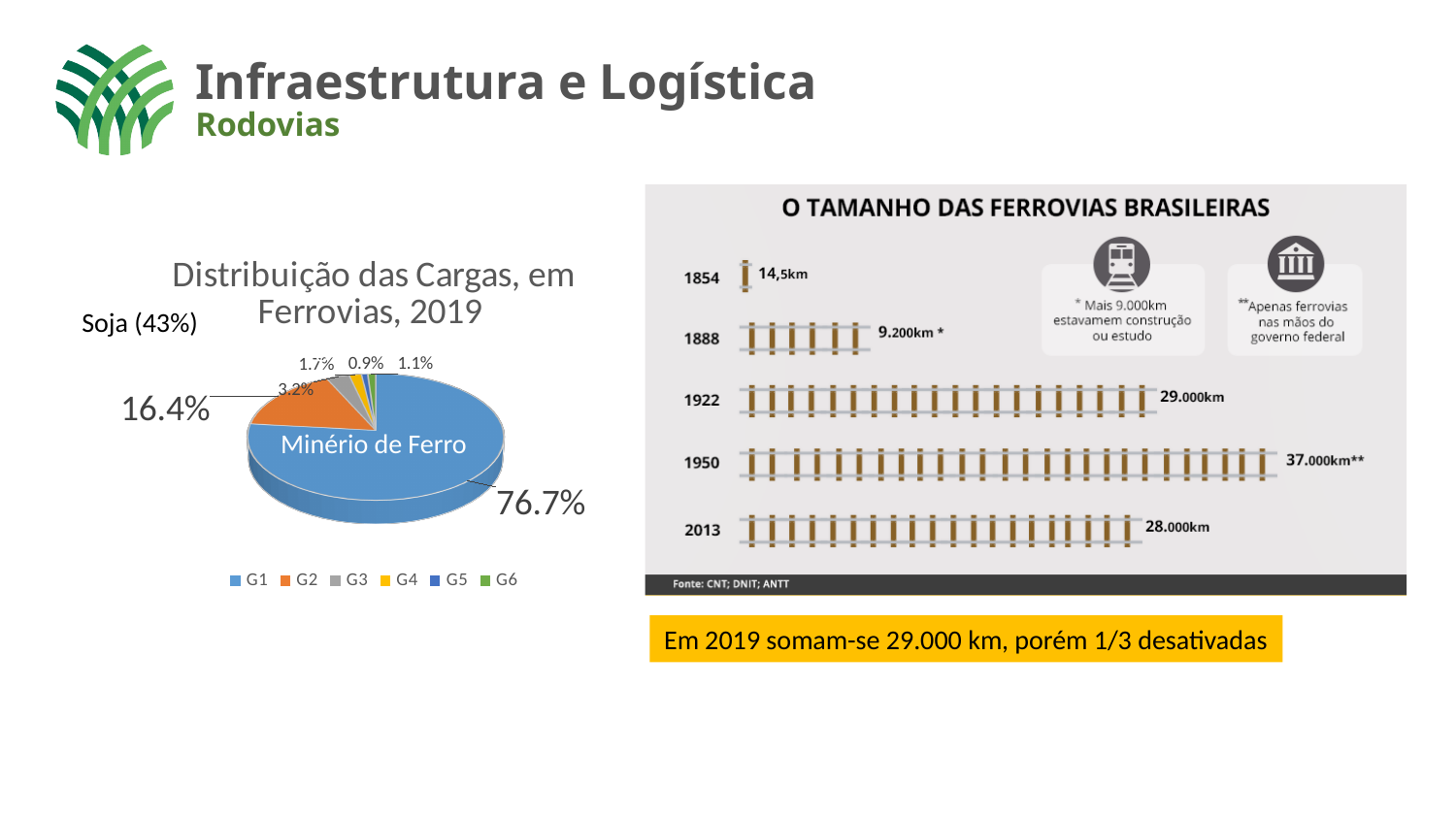
What kind of chart is 'Distribuição das Cargas, em Ferrovias, 2019'? pie chart In the pie chart 'Distribuição das Cargas, em Ferrovias, 2019', what is the value of the largest slice? 76.7% How many years are shown in the chart 'O Tamanho das Ferrovias Brasileiras'? 5 In the pie chart 'Distribuição das Cargas, em Ferrovias, 2019', what is the smallest percentage shown? 0.9% In the pie chart 'Distribuição das Cargas, em Ferrovias, 2019', what is the difference between the largest slice (76.7%) and the second largest (16.4%)? 60.3% In the pie chart 'Distribuição das Cargas, em Ferrovias, 2019', what label is written inside the largest slice? Minério de Ferro How many entries does the legend of the pie chart 'Distribuição das Cargas, em Ferrovias, 2019' list? 6 In the chart 'O Tamanho das Ferrovias Brasileiras', what is the value shown for 2013? 28.000km In the pie chart 'Distribuição das Cargas, em Ferrovias, 2019', what is the value of the orange slice (G2)? 16.4% In the pie chart 'Distribuição das Cargas, em Ferrovias, 2019', which legend entry corresponds to the largest slice? G1 In the pie chart 'Distribuição das Cargas, em Ferrovias, 2019', which is larger: the slice labelled 3.2% or the slice labelled 1.7%? 3.2% In the chart 'O Tamanho das Ferrovias Brasileiras', which year has the highest value? 1950